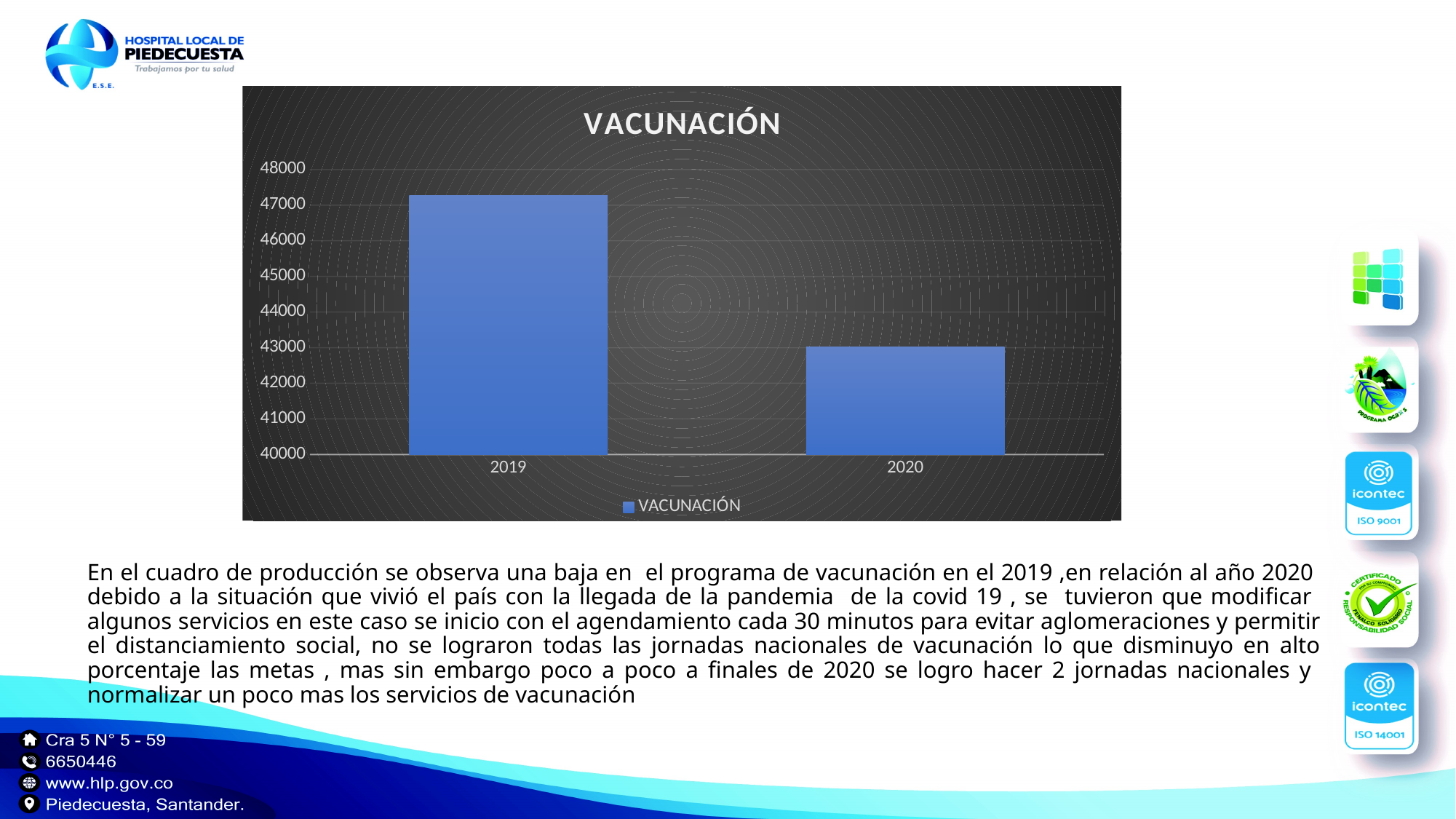
Which is larger, the value for 2019 or the value for 2020? 2019 What series name appears in the chart legend? VACUNACIÓN Is the value for 2020 greater or less than 44000? less What is the title of the chart? VACUNACIÓN Is the value for 2019 greater or less than 46000? greater Is the value for 2020 greater or less than 42000? greater How many categories are shown on the x axis of the chart? 2 How many series does the chart legend list? 1 Which year has the lowest value in the chart? 2020 Do the values rise or fall from 2019 to 2020? fall Which year has the highest value in the chart? 2019 What kind of chart is shown on the slide? bar chart